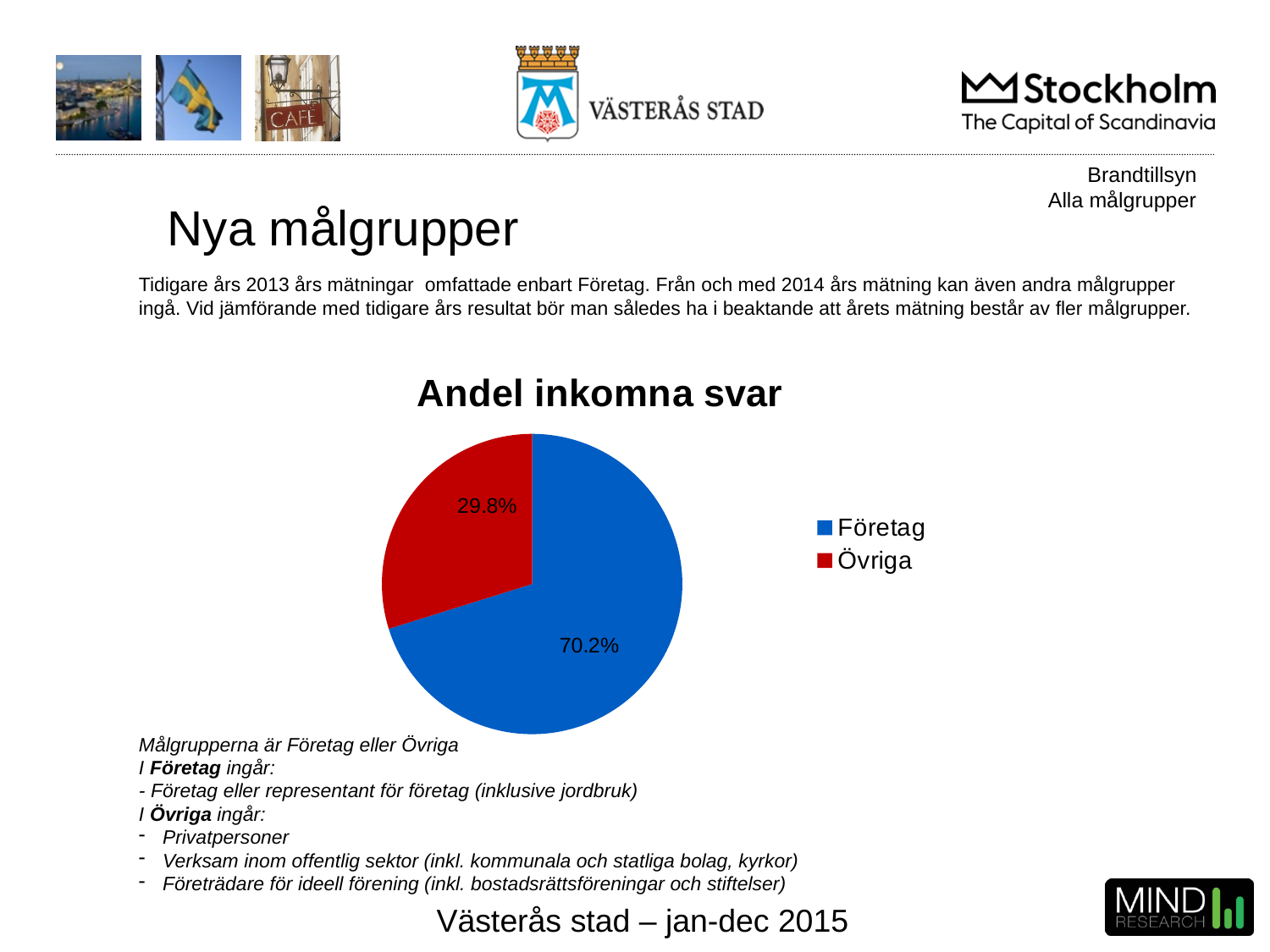
What kind of chart is shown on the slide? Pie chart Which category has the smallest slice of the pie? Övriga What colour is the Övriga slice? Red What is the title of the chart? Andel inkomna svar Which category has the largest slice of the pie? Företag What is the difference in percentage points between the Företag and Övriga slices? 40.4 How many slices does the pie chart have? 2 What share of the pie does Övriga account for? 29.8% How many entries does the legend list? 2 Which slice is larger, Företag or Övriga? Företag What share of the pie does Företag account for? 70.2%